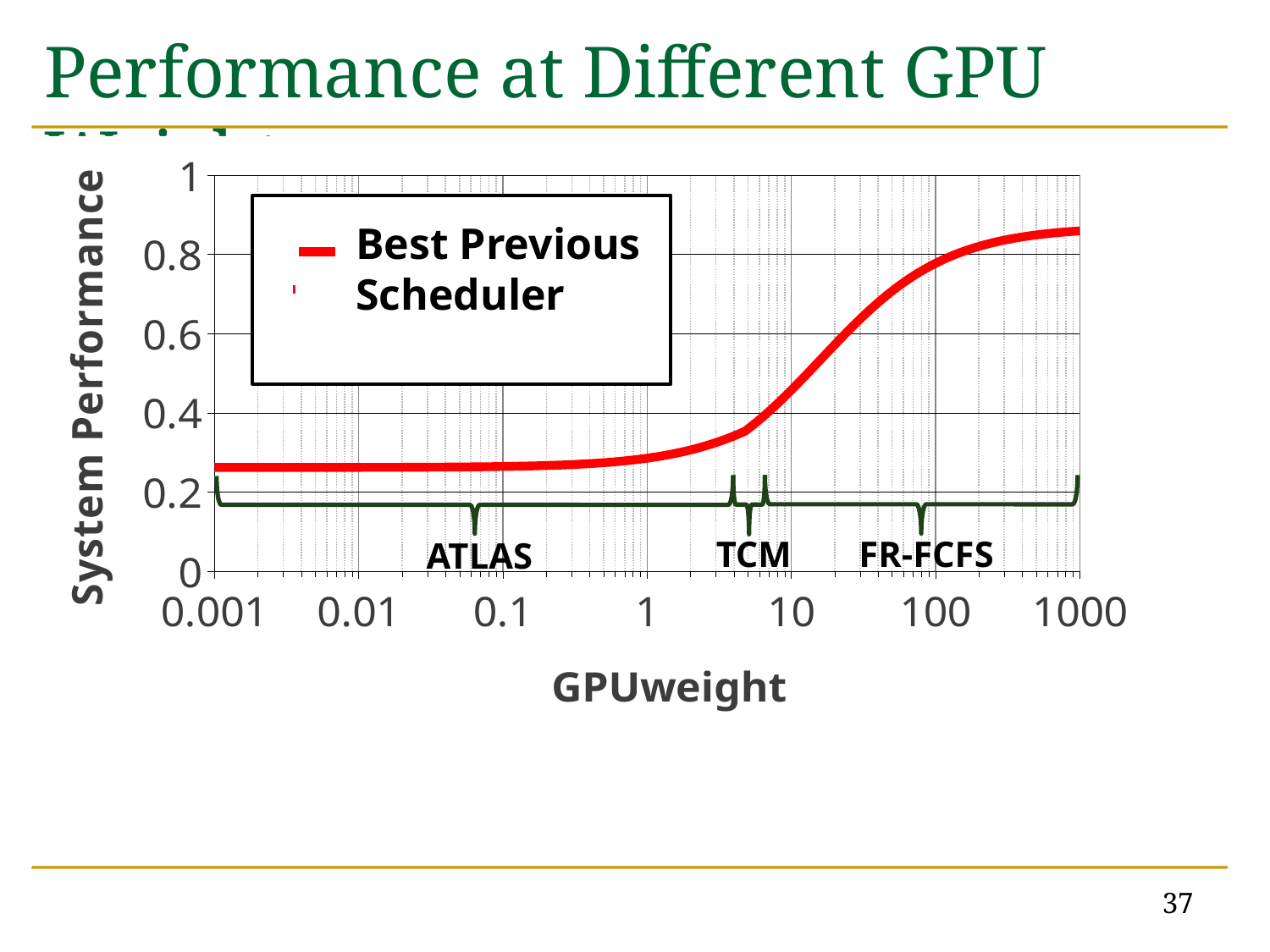
Is the System Performance value at GPUweight 1000 greater or less than 0.8? greater Is the System Performance value at GPUweight 0.001 greater or less than 0.2? greater What is the name of the series shown in the legend? Best Previous Scheduler What kind of chart is shown on the slide? line chart How many series does the legend list? 1 Is the System Performance value at GPUweight 0.1 greater or less than 0.6? less Does System Performance rise or fall as GPUweight increases along the x axis? rise Which is larger, the System Performance at GPUweight 1000 or at GPUweight 0.01? GPUweight 1000 What is the title of the x axis? GPUweight